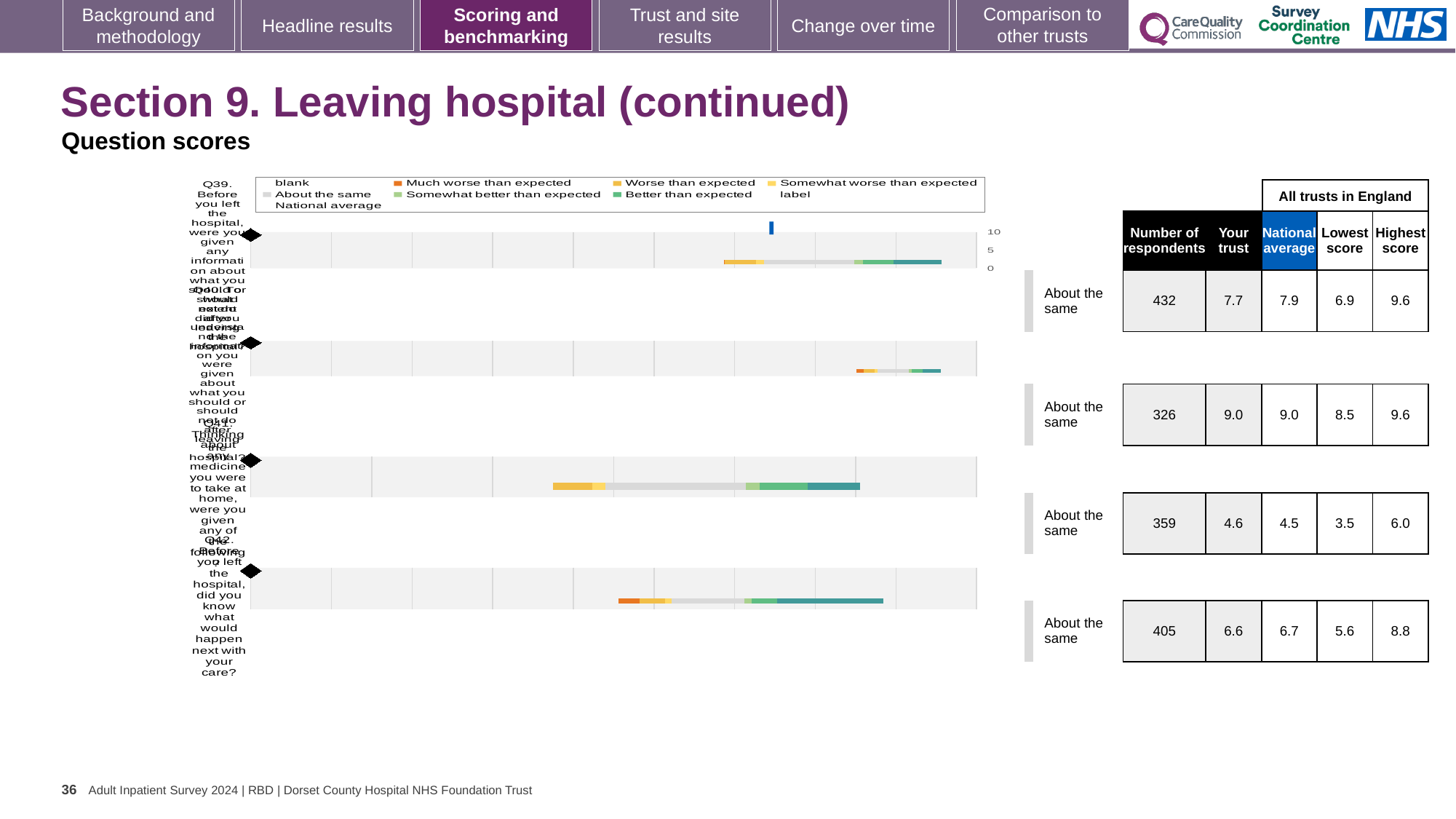
In the table to the right of the charts, what is the 'National average' in the third row (aligned with the Q41 chart)? 4.5 How many separate question-score bar charts are shown on the slide? 4 In the table to the right of the charts, which row has the highest 'Number of respondents'? the first row (432) In the table to the right of the charts, which row has the lowest 'Your trust' score? the third row (4.6) In the table to the right of the charts, what is the 'Number of respondents' in the second row (aligned with the Q40 chart)? 326 What is the highest value shown on the axis above the first (Q39) chart? 10 What kind of chart is used for the question scores on this slide? bar chart In the table to the right of the charts, what is the 'Your trust' score in the first row (aligned with the Q39 chart)? 7.7 In the table to the right of the charts, what is the difference between the 'Highest score' and 'Lowest score' in the first row? 2.7 In the table to the right of the charts, is the 'Your trust' score in the fourth row larger or smaller than the 'National average' in that row? smaller Which colour does the legend use for 'Much worse than expected'? orange In the table to the right of the charts, what is the 'Highest score' in the fourth row (aligned with the Q42 chart)? 8.8